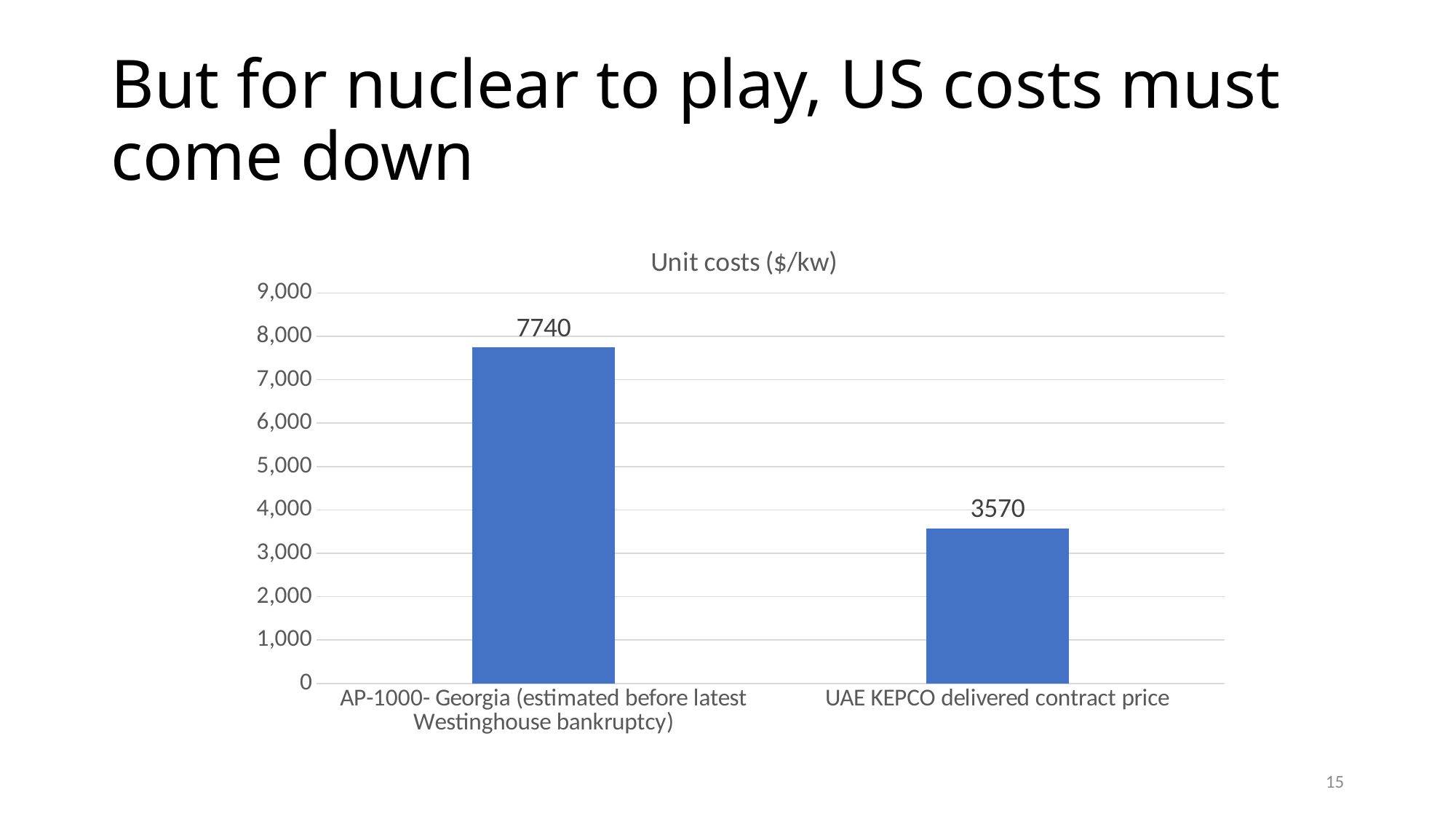
What is the unit cost for UAE KEPCO delivered contract price? 3570 Is the unit cost for UAE KEPCO delivered contract price greater or less than 4,000? less Which category has the highest unit cost? AP-1000- Georgia (estimated before latest Westinghouse bankruptcy) What is the highest value shown on the vertical axis? 9,000 What is the difference in unit cost between AP-1000- Georgia and UAE KEPCO delivered contract price? 4170 How many categories are shown in the chart? 2 Is the unit cost for AP-1000- Georgia greater or less than 7,000? greater Which is larger, the unit cost for AP-1000- Georgia or for UAE KEPCO delivered contract price? AP-1000- Georgia What is the unit cost for AP-1000- Georgia (estimated before latest Westinghouse bankruptcy)? 7740 What is the title of the chart? Unit costs ($/kw) What kind of chart is shown on the slide? bar chart Which category has the lowest unit cost? UAE KEPCO delivered contract price